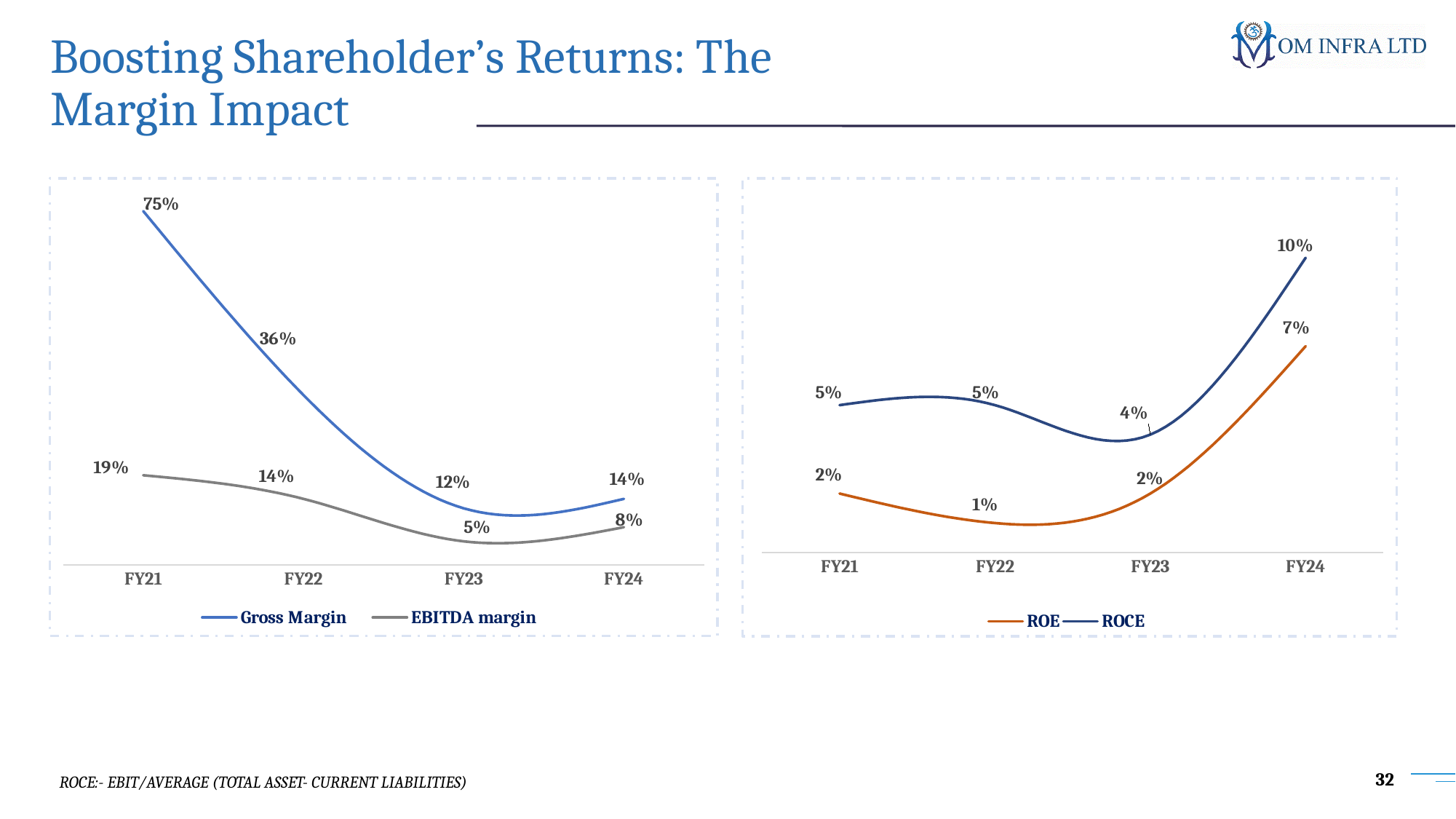
In the right chart (ROE / ROCE), what is the ROCE for FY24? 10% In the right chart (ROE / ROCE), which fiscal year has the highest ROE? FY24 In the left chart (Gross Margin / EBITDA margin), what is the Gross Margin for FY21? 75% In the left chart (Gross Margin / EBITDA margin), which fiscal year has the lowest Gross Margin? FY23 In the left chart (Gross Margin / EBITDA margin), does the Gross Margin rise or fall from FY21 to FY23? fall In the right chart (ROE / ROCE), which is larger in FY23, ROE or ROCE? ROCE In the right chart (ROE / ROCE), what is the ROE for FY22? 1% In the left chart (Gross Margin / EBITDA margin), how many series does the legend list? 2 In the right chart (ROE / ROCE), what is the difference between ROCE and ROE in FY24? 3% What kind of chart is the right chart (ROE / ROCE)? line chart In the left chart (Gross Margin / EBITDA margin), what is the EBITDA margin for FY23? 5% In the left chart (Gross Margin / EBITDA margin), what is the difference between the Gross Margin and the EBITDA margin in FY22? 22%